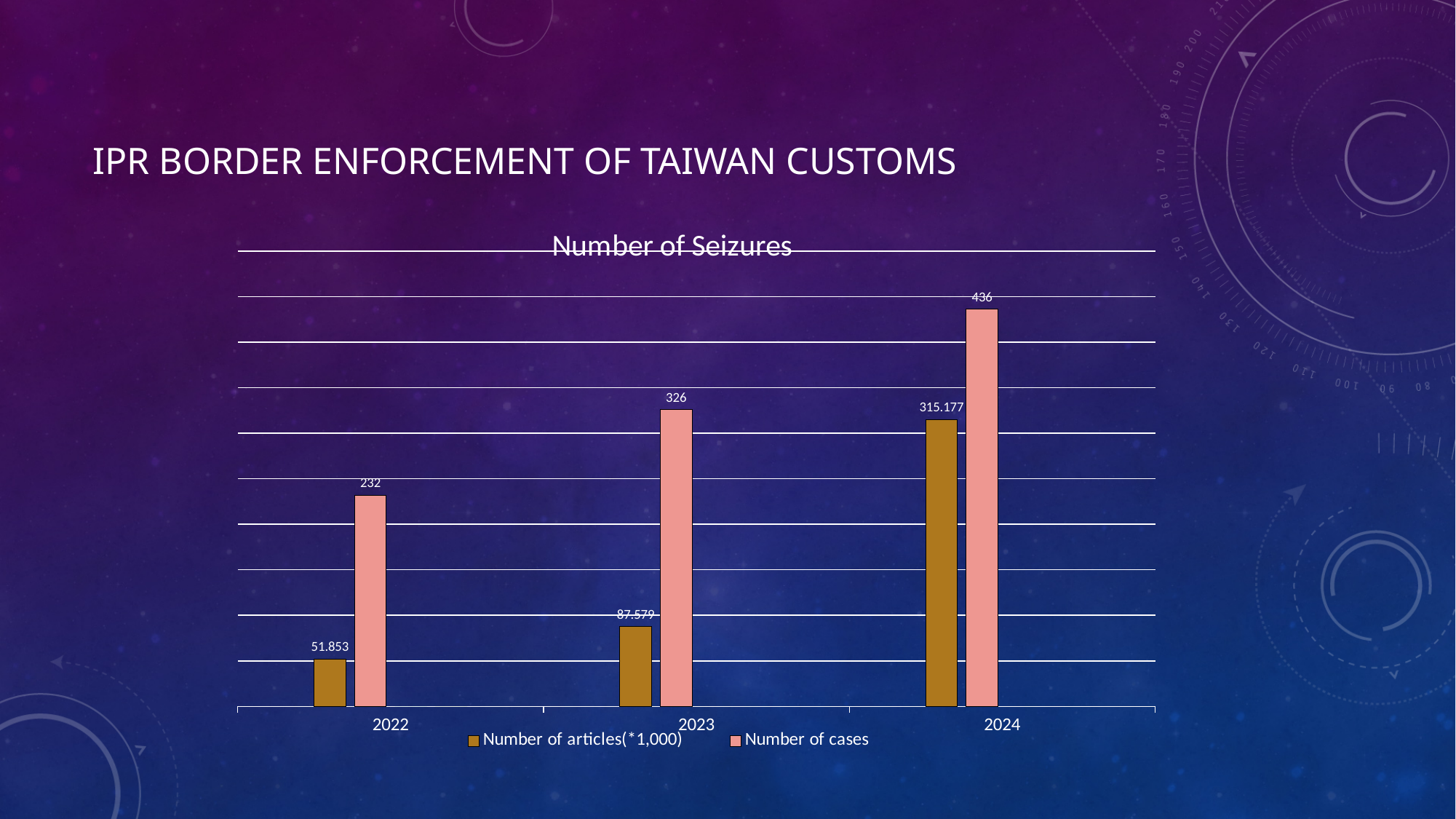
Which is larger, the Number of articles(*1,000) in 2023 or in 2024? 2024 How many years are shown on the x axis of the chart? 3 What is the Number of cases for 2023? 326 Does the Number of cases rise or fall from 2022 to 2024? Rise What is the Number of articles(*1,000) for 2024? 315.177 What is the difference in Number of cases between 2023 and 2022? 94 Which year has the highest Number of cases? 2024 How many series does the chart's legend list? 2 What kind of chart is shown on the slide? Bar chart Which year has the lowest Number of articles(*1,000)? 2022 What is the difference in Number of cases between 2024 and 2022? 204 What is the Number of articles(*1,000) for 2022? 51.853